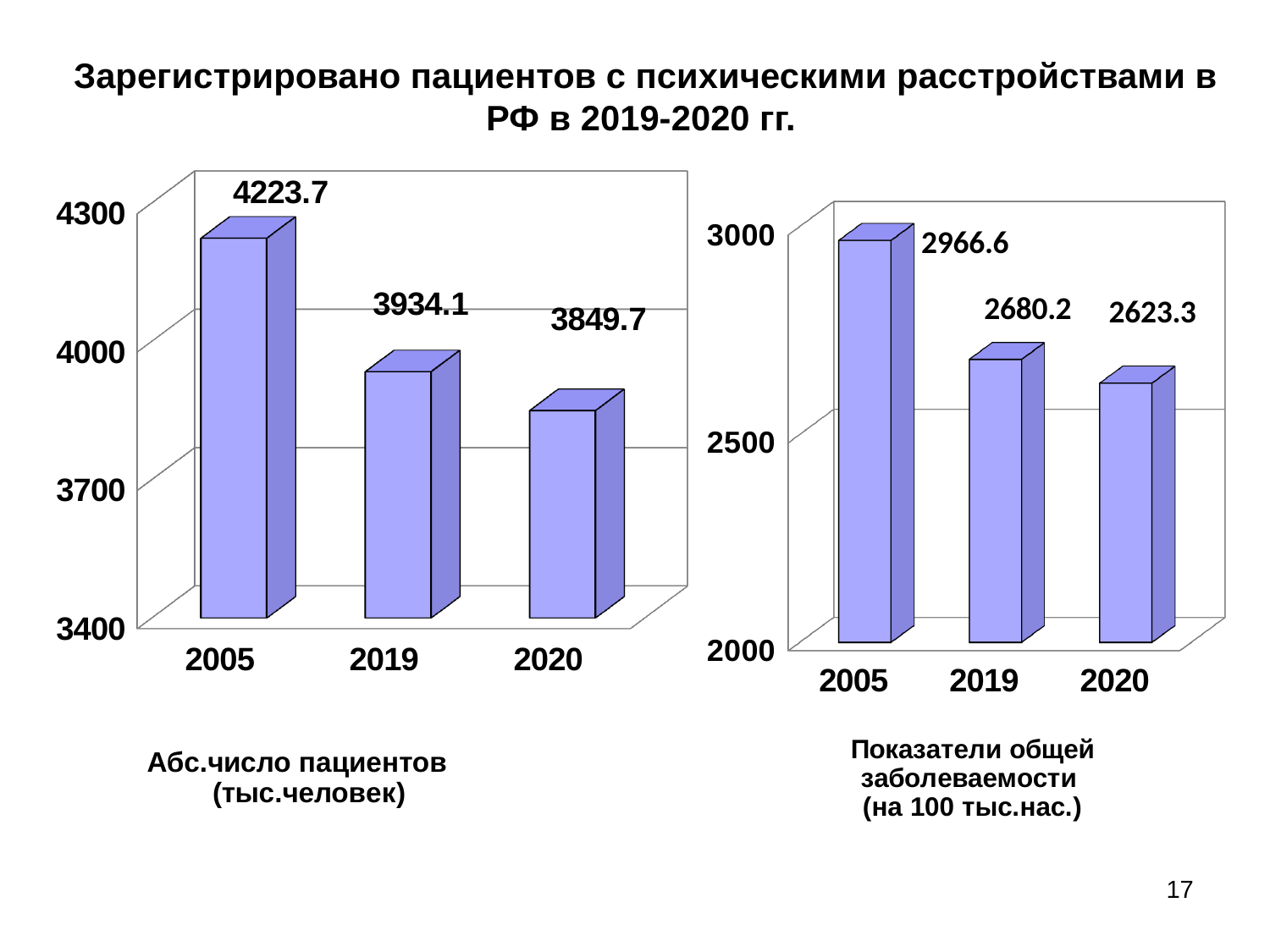
In the left chart (Абс.число пациентов), what is the value for 2005? 4223.7 In the left chart (Абс.число пациентов), what is the difference between the values for 2005 and 2019? 289.6 In the right chart (Показатели общей заболеваемости), what is the value for 2019? 2680.2 In the left chart (Абс.число пациентов), do the values rise or fall from 2005 to 2020? fall How many years are shown on the x axis of the left chart (Абс.число пациентов)? 3 In the right chart (Показатели общей заболеваемости), what is the difference between the values for 2019 and 2020? 56.9 In the right chart (Показатели общей заболеваемости), is the value for 2005 larger or smaller than the value for 2020? larger In the left chart (Абс.число пациентов), which year has the highest value? 2005 In the right chart (Показатели общей заболеваемости), which year has the lowest value? 2020 In the right chart (Показатели общей заболеваемости), what is the value for 2020? 2623.3 What type of chart is the right chart (Показатели общей заболеваемости)? bar chart In the left chart (Абс.число пациентов), what is the value for 2020? 3849.7